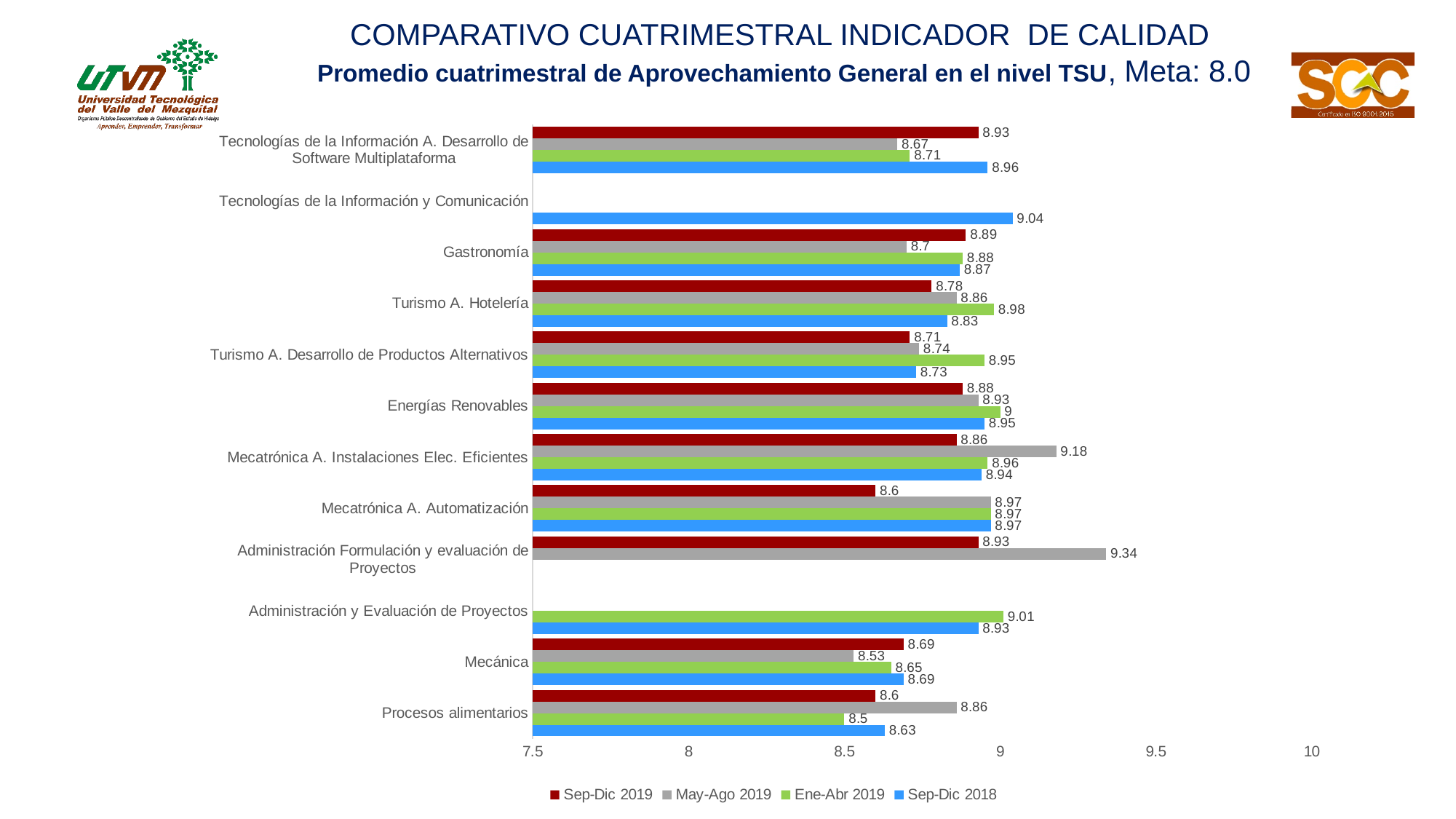
What is the Sep-Dic 2018 value for Tecnologías de la Información y Comunicación? 9.04 What is the Sep-Dic 2019 value for Gastronomía? 8.89 Which category has the lowest value in the Ene-Abr 2019 series? Procesos alimentarios For Procesos alimentarios, which is larger: the May-Ago 2019 value or the Sep-Dic 2018 value? May-Ago 2019 What target (Meta) is stated in the chart subtitle? 8.0 What is the May-Ago 2019 value for Mecatrónica A. Instalaciones Elec. Eficientes? 9.18 What is the difference between the Ene-Abr 2019 and Sep-Dic 2019 values for Turismo A. Desarrollo de Productos Alternativos? 0.24 Which category has the highest value in the May-Ago 2019 series? Administración Formulación y evaluación de Proyectos What type of chart is shown on the slide? Bar chart How many program categories are listed on the vertical axis? 12 How many series does the legend list? 4 Is the Sep-Dic 2019 value for Mecatrónica A. Automatización greater or less than 9? less